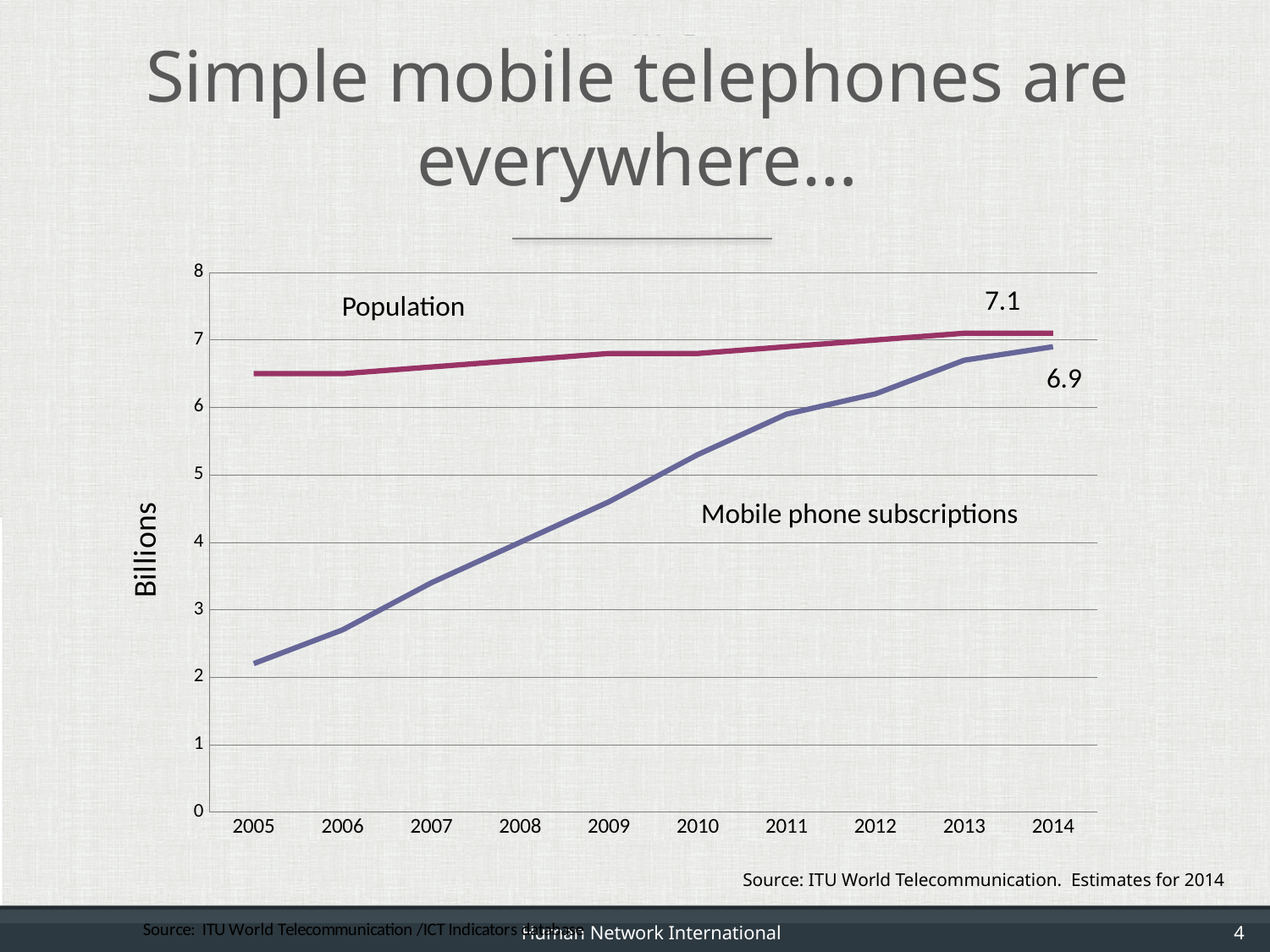
How many years are shown on the x axis? 10 What is the value for Population in 2014? 7.1 Is the value for Population in 2005 greater or less than 6? greater In 2014, which is larger: Population or Mobile phone subscriptions? Population How many data series are plotted on the chart? 2 Is the value for Mobile phone subscriptions in 2005 greater or less than 3? less Do Mobile phone subscriptions rise or fall from 2005 to 2014? Rise In which year are Mobile phone subscriptions lowest? 2005 What is the label on the y axis? Billions What is the difference between Population and Mobile phone subscriptions in 2014? 0.2 What kind of chart is shown on the slide? Line chart What is the value for Mobile phone subscriptions in 2014? 6.9